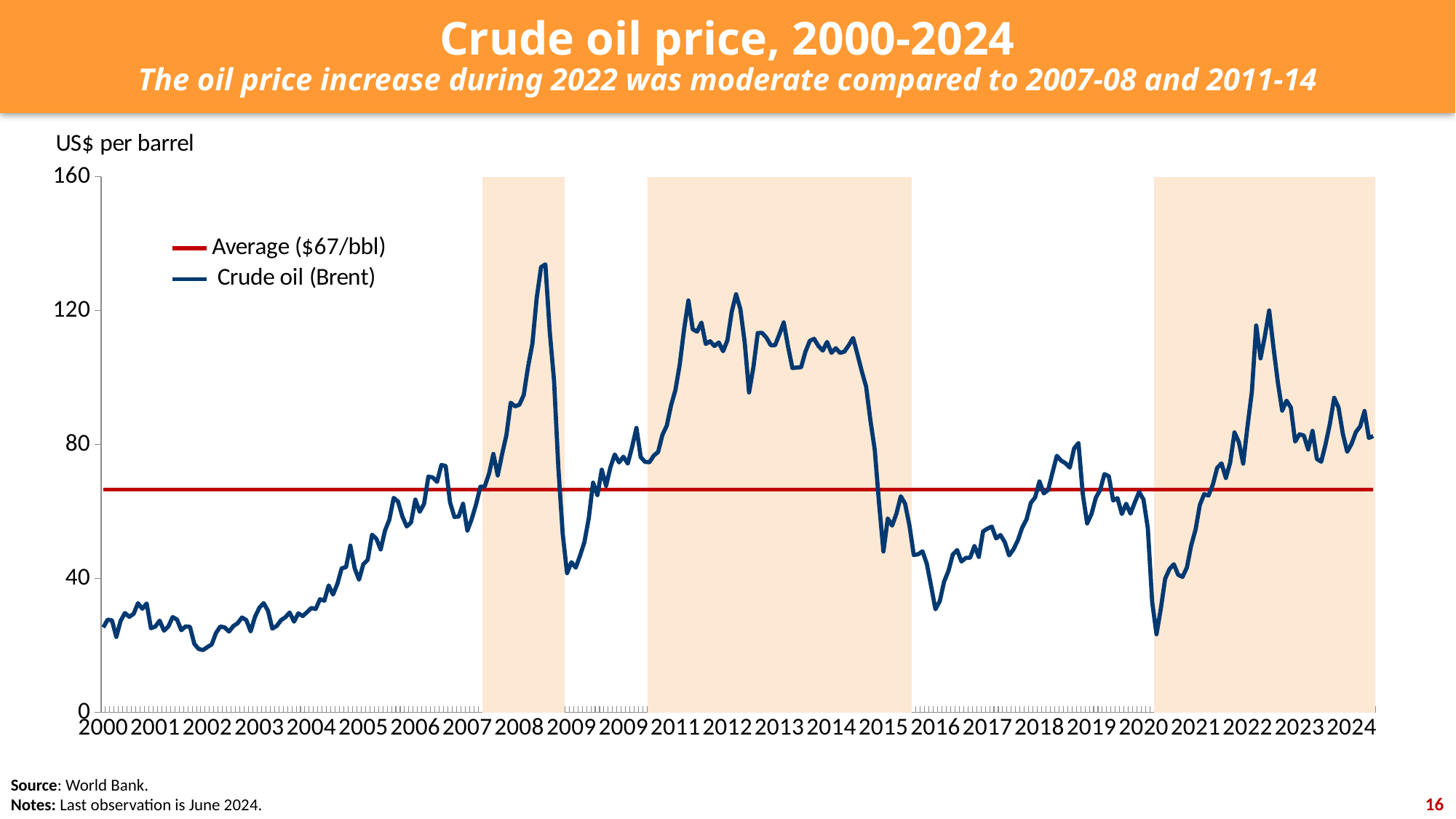
What is the title of the chart? Crude oil price, 2000-2024 Does the crude oil price rise or fall between 2002 and the 2008 peak? rise Is the peak crude oil price in 2008 greater or less than 120? greater Is the lowest crude oil price in 2020 greater or less than 40? less What kind of chart is shown on the slide? line chart What is the average crude oil price shown by the red line, according to the legend? $67/bbl What unit is the y axis measured in? US$ per barrel How many series does the legend list? 2 Is the crude oil price in 2012 greater or less than 80? greater Which is higher, the 2008 peak or the 2022 peak of the crude oil price? 2008 peak In which year does the crude oil price reach its highest peak? 2008